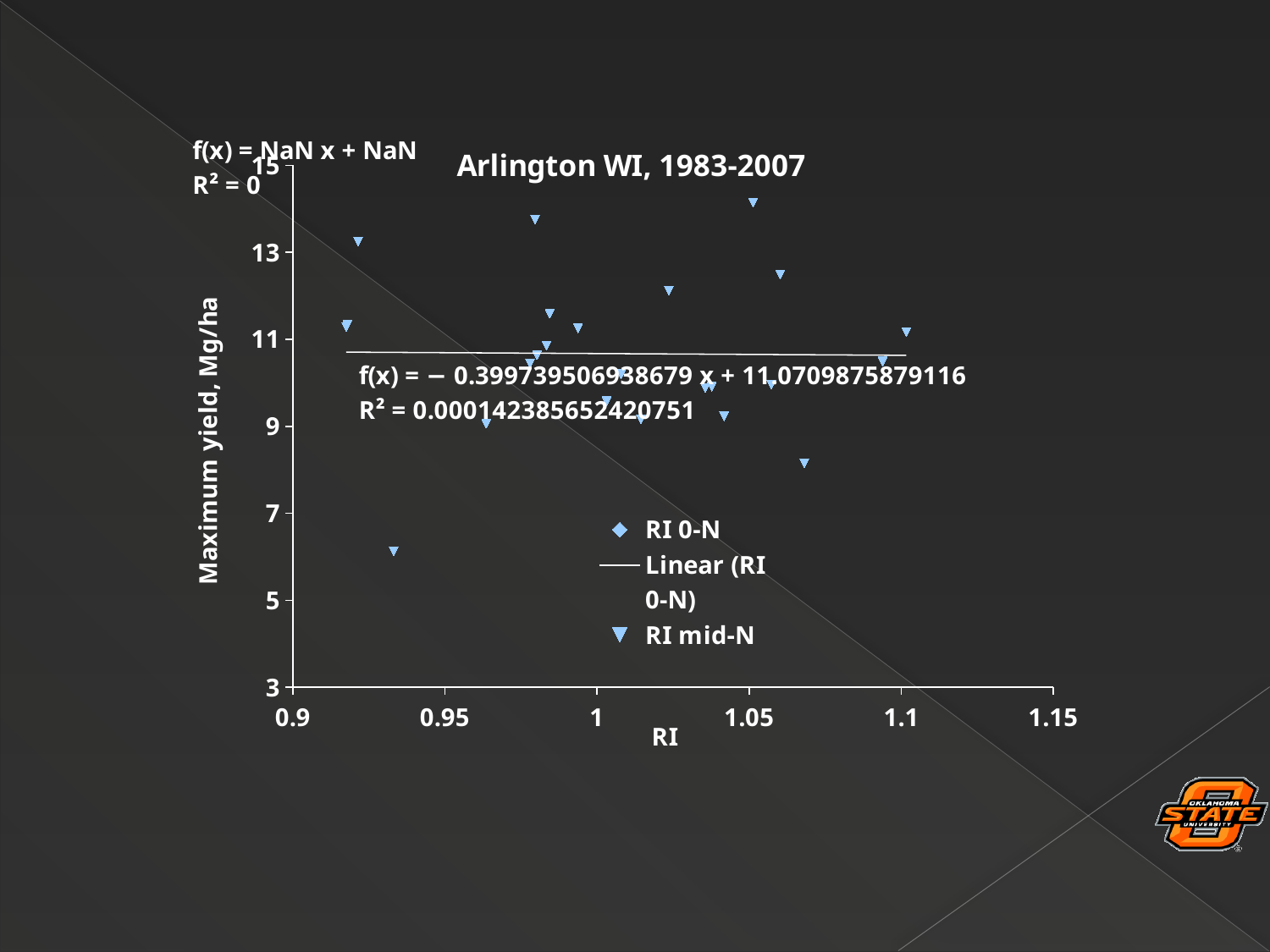
What is the label of the x axis? RI What kind of chart is shown on the slide? scatter chart What is the label of the y axis? Maximum yield, Mg/ha What is the intercept of the fitted line shown in the equation on the chart? 11.0709875879116 What is the maximum value shown on the x axis? 1.15 What is the slope of the fitted line shown in the equation f(x) = −0.399739506938679 x + 11.0709875879116? −0.399739506938679 Does the fitted linear trend line rise or fall as RI increases? falls slightly (nearly flat) What R² value is printed for the fitted line with the non-NaN equation? 0.000142385652420751 Is the highest plotted yield value greater or less than 13? greater What is the title of the chart? Arlington WI, 1983-2007 Is the lowest plotted yield value greater or less than 7? less How many entries does the legend list? 3